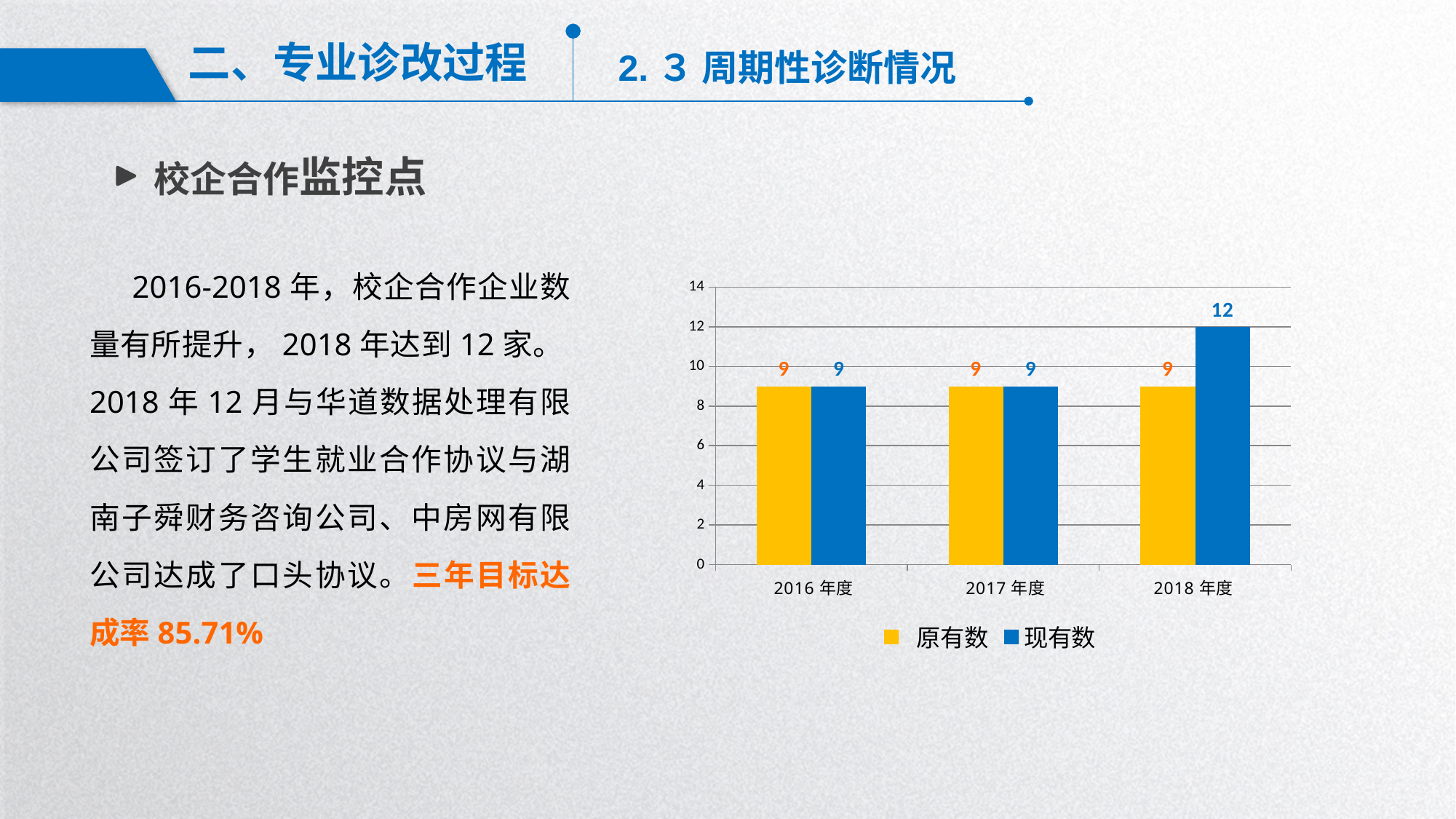
What is the value of 现有数 for 2017 年度? 9 Which colour represents 原有数 in the legend? yellow Is the value of 现有数 for 2018 年度 greater or less than 10? greater Which year has the highest 现有数 value? 2018 年度 How many year categories are shown on the x axis? 3 What is the value of 现有数 for 2018 年度? 12 How many series does the legend list? 2 Does the 现有数 series rise or fall from 2017 年度 to 2018 年度? rise What kind of chart is shown on the slide? bar chart What is the value of 原有数 for 2016 年度? 9 Which is larger for 2018 年度, 原有数 or 现有数? 现有数 What is the difference between 现有数 and 原有数 for 2018 年度? 3